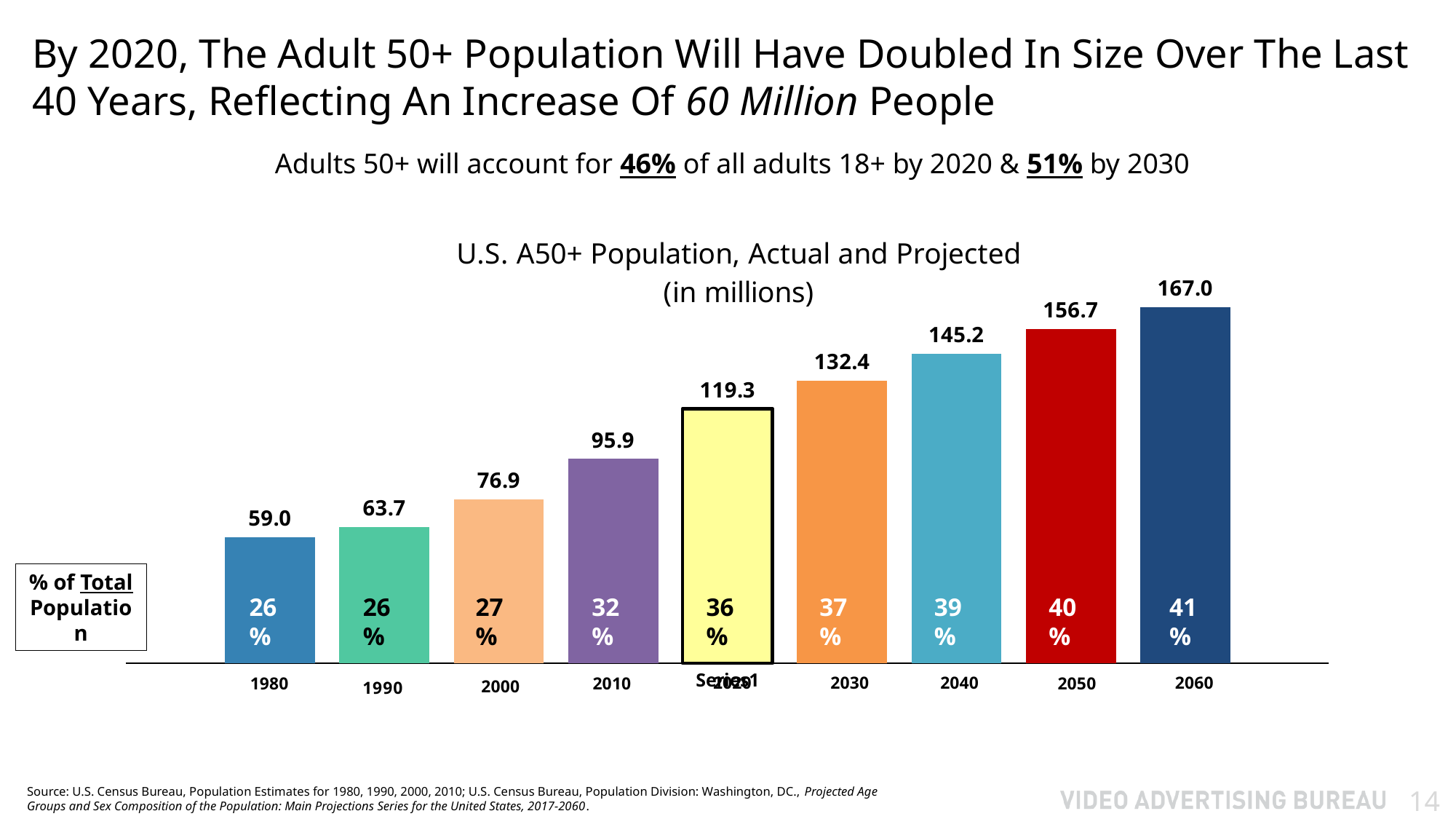
What is the U.S. A50+ population (in millions) shown for 1980? 59.0 How many years (bars) are shown in the chart? 9 What is the U.S. A50+ population (in millions) shown for 2060? 167.0 What is the U.S. A50+ population (in millions) shown for 2040? 145.2 What percentage of the total population does the 2050 bar show? 40% Which year has the lowest A50+ population value? 1980 Which year has the highest A50+ population value? 2060 Which is larger, the A50+ population value for 2000 or for 1990? 2000 What is the difference between the A50+ population values for 2030 and 2010? 36.5 What type of chart is shown on the slide? bar chart Do the A50+ population values rise or fall from 1980 to 2060? rise What is the difference between the A50+ population values for 2060 and 1980? 108.0